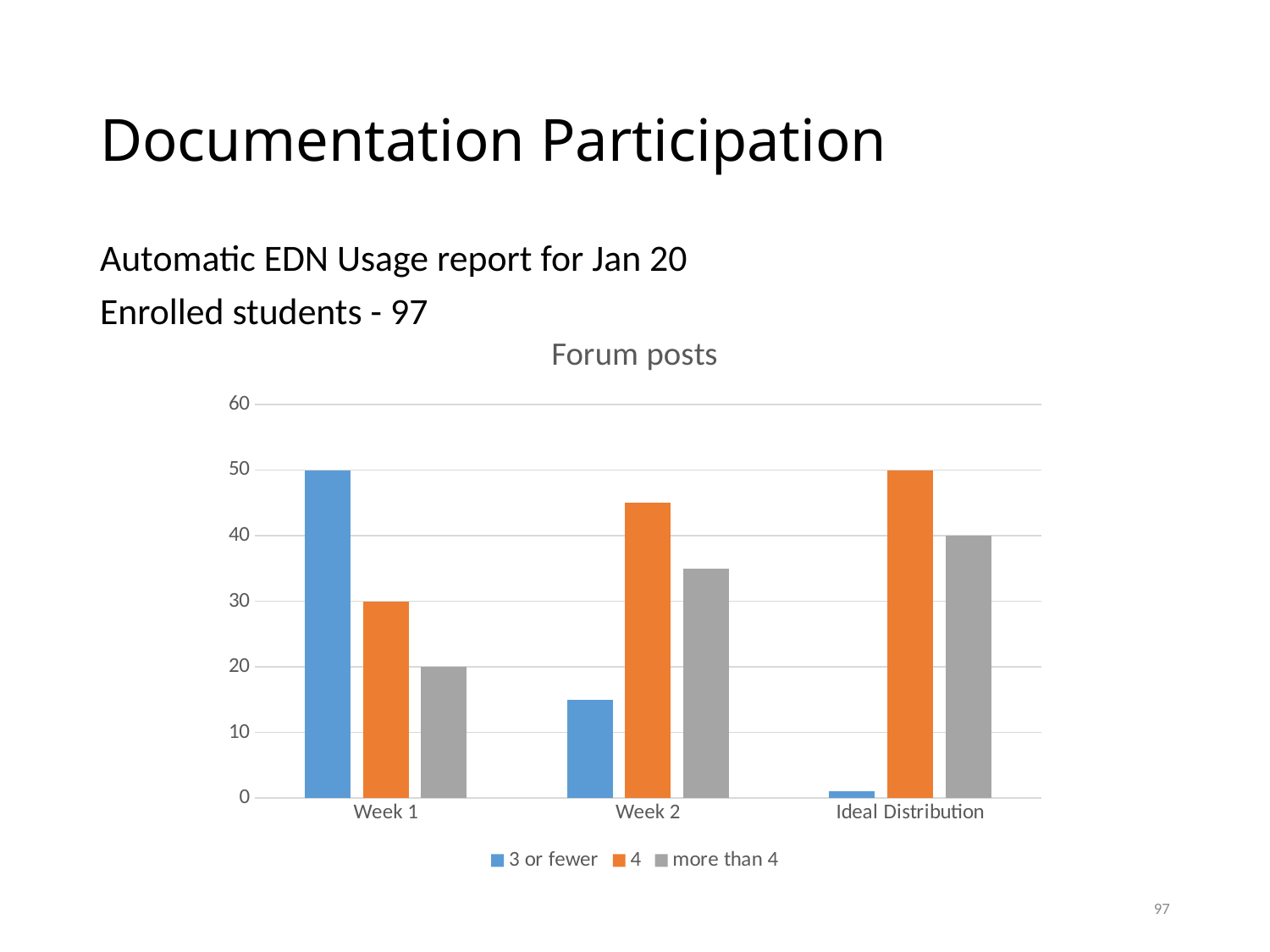
What is the title of the chart? Forum posts What is the value for '4' in Ideal Distribution? 50 Which series has the highest value in Week 1? 3 or fewer What kind of chart is shown on the slide? bar chart What is the value for '4' in Week 1? 30 What is the value for '3 or fewer' in Week 1? 50 Is the value for '4' in Week 2 greater or less than 40? greater What is the value for 'more than 4' in Ideal Distribution? 40 How many series does the legend list? 3 How many categories are shown on the x axis? 3 What is the value for 'more than 4' in Week 1? 20 Is the value for '3 or fewer' in Week 2 greater or less than 20? less